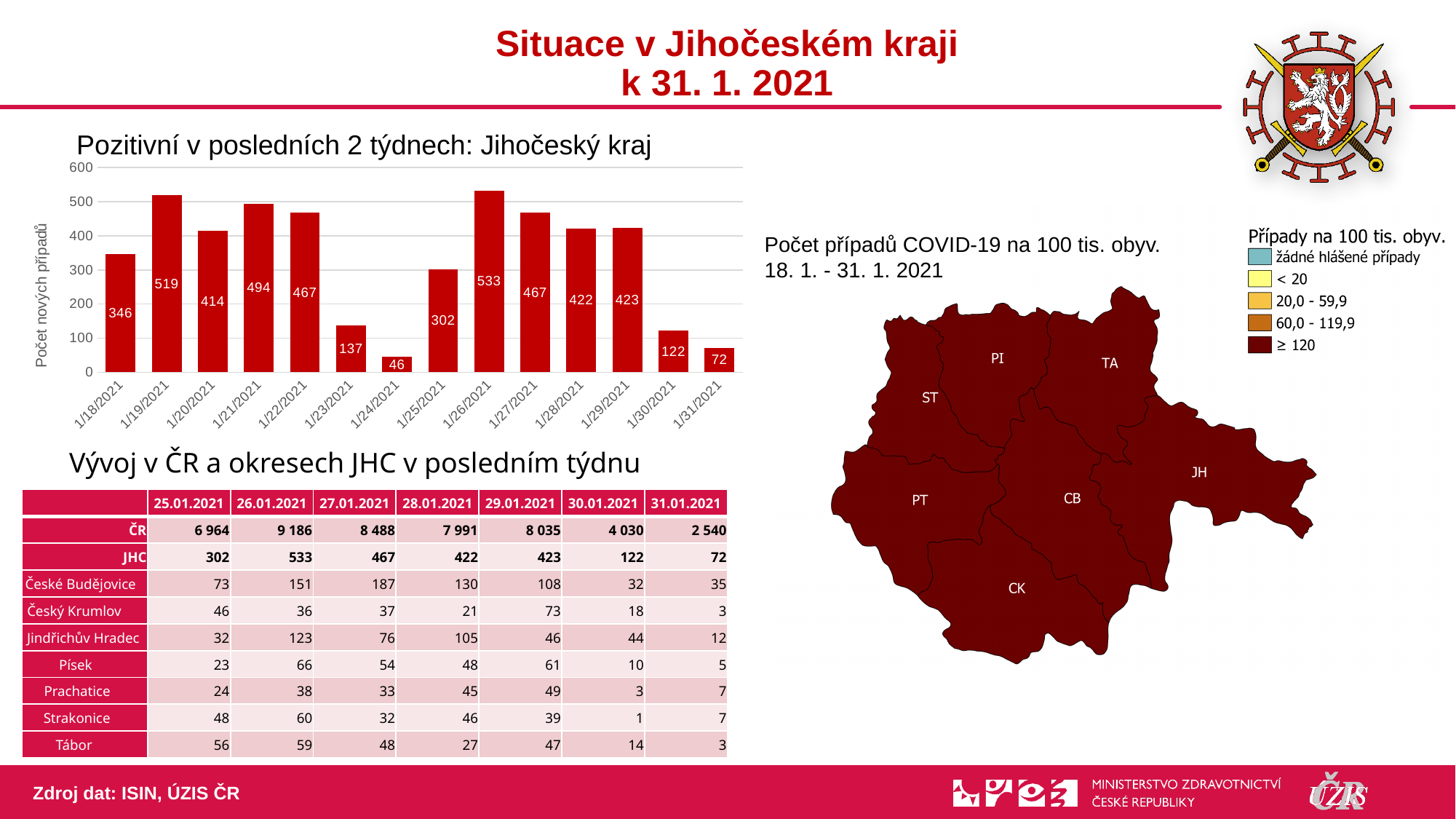
In the chart 'Pozitivní v posledních 2 týdnech: Jihočeský kraj', which date has the highest value? 1/26/2021 In the chart 'Pozitivní v posledních 2 týdnech: Jihočeský kraj', what is the value for 1/31/2021? 72 How many dates (bars) are shown in the chart 'Pozitivní v posledních 2 týdnech: Jihočeský kraj'? 14 In the chart 'Pozitivní v posledních 2 týdnech: Jihočeský kraj', do the values rise or fall from 1/26/2021 to 1/31/2021? fall In the chart 'Pozitivní v posledních 2 týdnech: Jihočeský kraj', what is the value for 1/23/2021? 137 What type of chart is used to show 'Pozitivní v posledních 2 týdnech: Jihočeský kraj'? bar chart What is the y-axis title of the chart 'Pozitivní v posledních 2 týdnech: Jihočeský kraj'? Počet nových případů In the chart 'Pozitivní v posledních 2 týdnech: Jihočeský kraj', which date has the lowest value? 1/24/2021 In the chart 'Pozitivní v posledních 2 týdnech: Jihočeský kraj', which is larger, the value for 1/21/2021 or 1/22/2021? 1/21/2021 In the chart 'Pozitivní v posledních 2 týdnech: Jihočeský kraj', what is the difference between the values for 1/19/2021 and 1/18/2021? 173 In the chart 'Pozitivní v posledních 2 týdnech: Jihočeský kraj', is the value for 1/20/2021 greater or less than 300? greater In the chart 'Pozitivní v posledních 2 týdnech: Jihočeský kraj', what is the value for 1/18/2021? 346